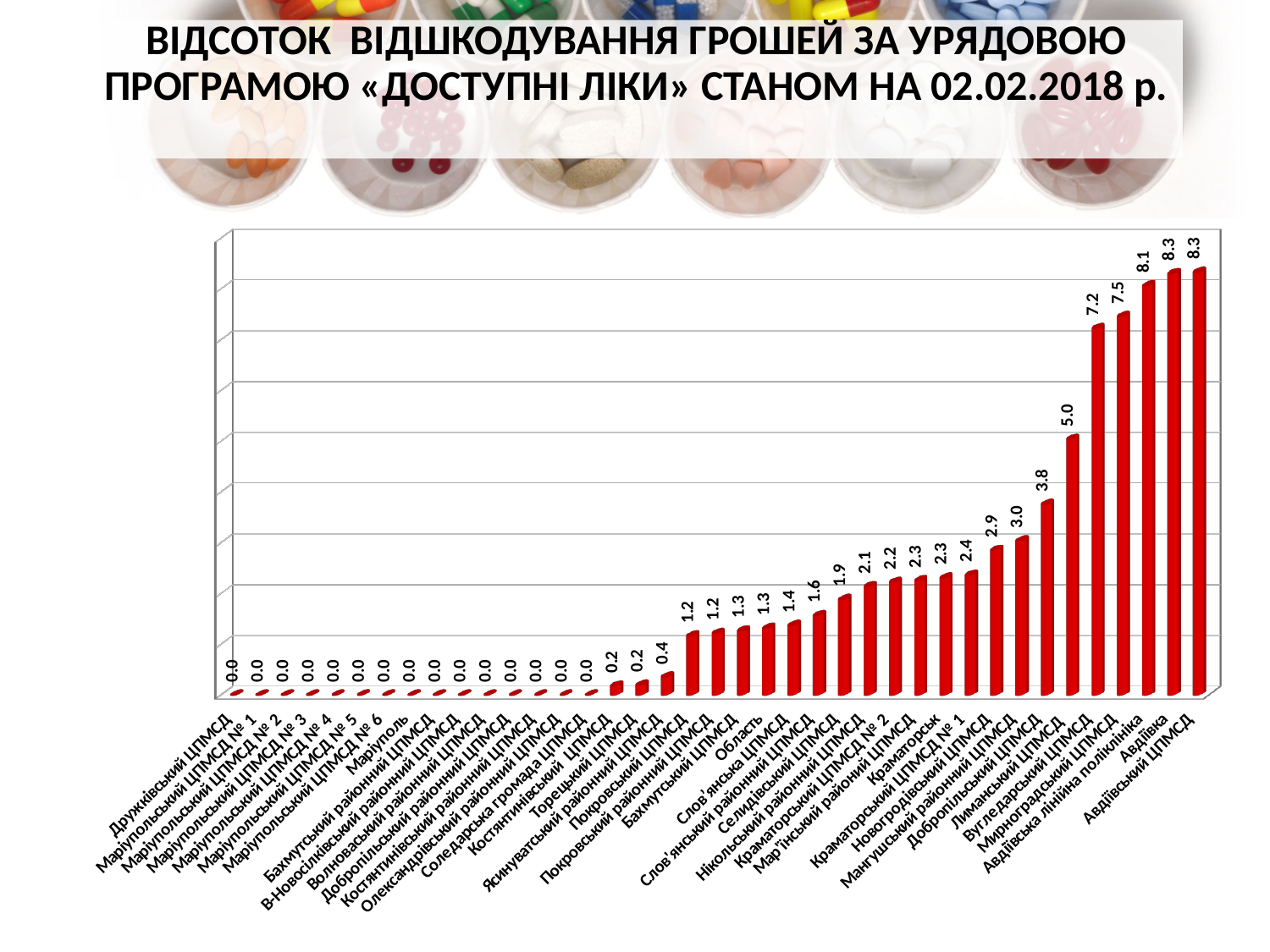
What is the difference between the values for Лиманський ЦПМСД and Добропільський ЦПМСД? 1.2 What colour are the bars in the chart? red Do the values rise or fall from left to right along the x axis? rise What is the value for Авдіївська лінійна поліклініка? 8.1 What is the value for Ясинуватський районний ЦПМСД? 0.4 What kind of chart is shown on the slide? bar chart What is the value for Вугледарський ЦПМСД? 7.2 Which is larger, the value for Вугледарський ЦПМСД or the value for Лиманський ЦПМСД? Вугледарський ЦПМСД What is the value for Добропільський ЦПМСД? 3.8 What is the value for Область? 1.3 What is the difference between the values for Мирноградський ЦПМСД and Вугледарський ЦПМСД? 0.3 What is the value for Лиманський ЦПМСД? 5.0